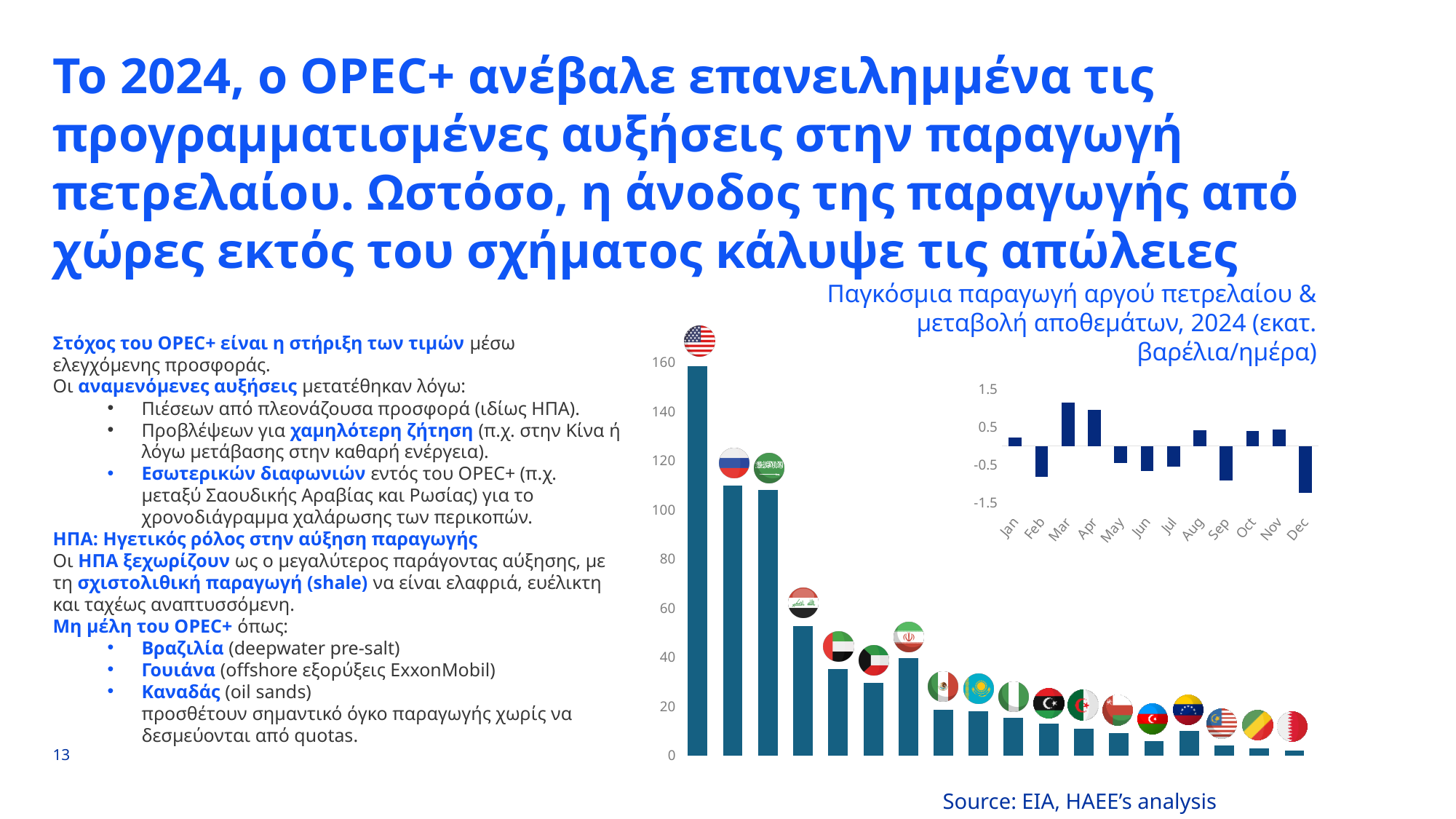
What is the title of the chart on the right of the slide? Παγκόσμια παραγωγή αργού πετρελαίου & μεταβολή αποθεμάτων, 2024 (εκατ. βαρέλια/ημέρα) In the small inset chart of monthly stock change, is the value for Feb greater or less than 0? less In the small inset chart of monthly stock change, which month has the lowest value? Dec In the large bar chart, do the bar values rise or fall from left to right? fall In the large bar chart, how many bars (countries) are plotted? 18 In the large bar chart, is the value of the first (tallest) bar, marked with the US flag, greater or less than 140? greater In the small inset chart of monthly stock change, how many months are plotted? 12 In the large bar chart, which is larger: the first bar (US flag) or the second bar (Russia flag)? the first bar (US flag) What kind of chart is the large chart on the right of the slide? bar chart In the large bar chart, which bar is the highest? the first bar (US flag) In the large bar chart, is the value of the fourth bar (Iraq flag) greater or less than 60? less In the small inset chart of monthly stock change, which month has the highest value? Mar